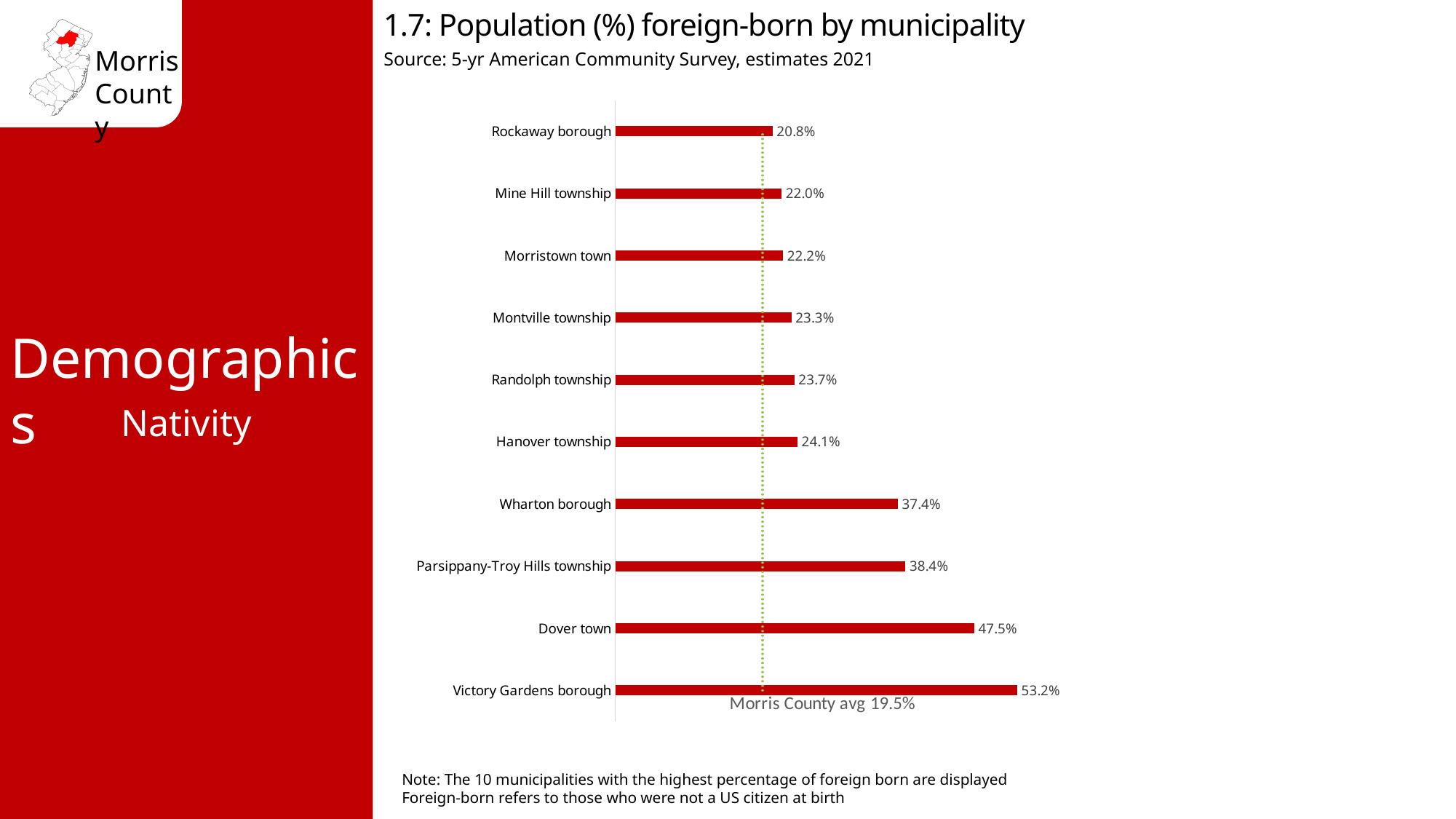
What is the Morris County average foreign-born percentage indicated by the dotted line? 19.5% Which municipality has the lowest foreign-born population percentage shown on the chart? Rockaway borough What is the foreign-born population percentage for Dover town? 47.5% What is the foreign-born population percentage for Morristown town? 22.2% What type of chart is used to show the foreign-born population by municipality? Bar chart What is the difference in foreign-born percentage between Wharton borough and Hanover township? 13.3% Which has a higher foreign-born percentage, Montville township or Randolph township? Randolph township What is the difference in foreign-born percentage between Victory Gardens borough and Dover town? 5.7% What is the foreign-born population percentage for Parsippany-Troy Hills township? 38.4% Which municipality has the highest foreign-born population percentage? Victory Gardens borough What is the source of the data shown in the chart? 5-yr American Community Survey, estimates 2021 How many municipalities are shown on the chart? 10